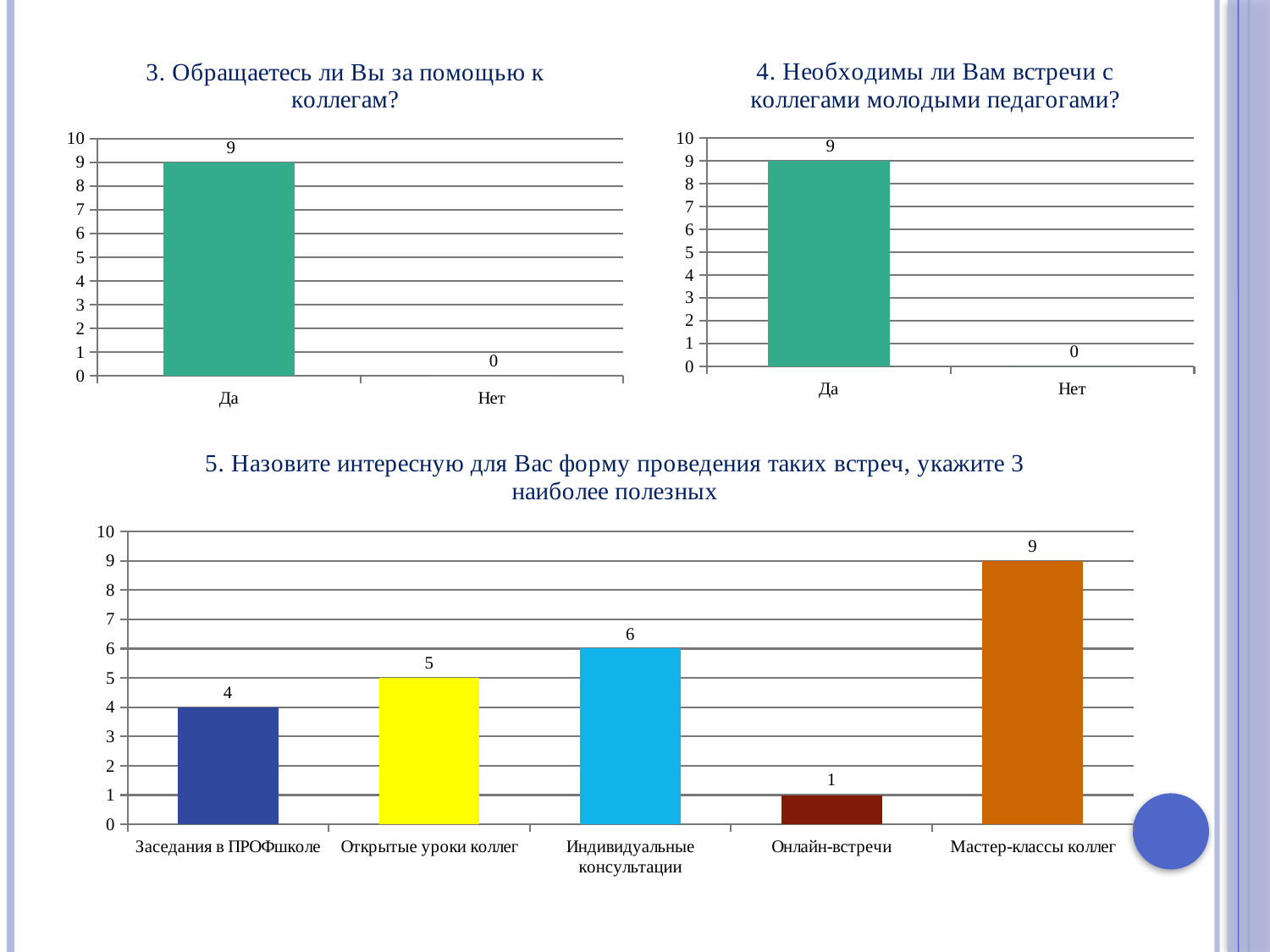
In the bottom chart (question 5), which category has the lowest value? Онлайн-встречи In the top-left chart (question 3, 'Обращаетесь ли Вы за помощью к коллегам?'), what is the value for 'Да'? 9 In the bottom chart (question 5), how many categories are shown? 5 In the top-right chart (question 4, 'Необходимы ли Вам встречи с коллегами молодыми педагогами?'), what is the value for 'Да'? 9 In the top-right chart (question 4), how many categories are shown on the x axis? 2 What type of chart is the bottom chart (question 5)? Bar chart In the bottom chart (question 5), what is the value for 'Мастер-классы коллег'? 9 In the bottom chart (question 5), what is the value for 'Онлайн-встречи'? 1 In the bottom chart (question 5), which category has the highest value? Мастер-классы коллег In the top-left chart (question 3), what is the value for 'Нет'? 0 In the bottom chart (question 5), which is larger: 'Открытые уроки коллег' or 'Индивидуальные консультации'? Индивидуальные консультации In the bottom chart (question 5), what is the difference between 'Индивидуальные консультации' and 'Заседания в ПРОФшколе'? 2